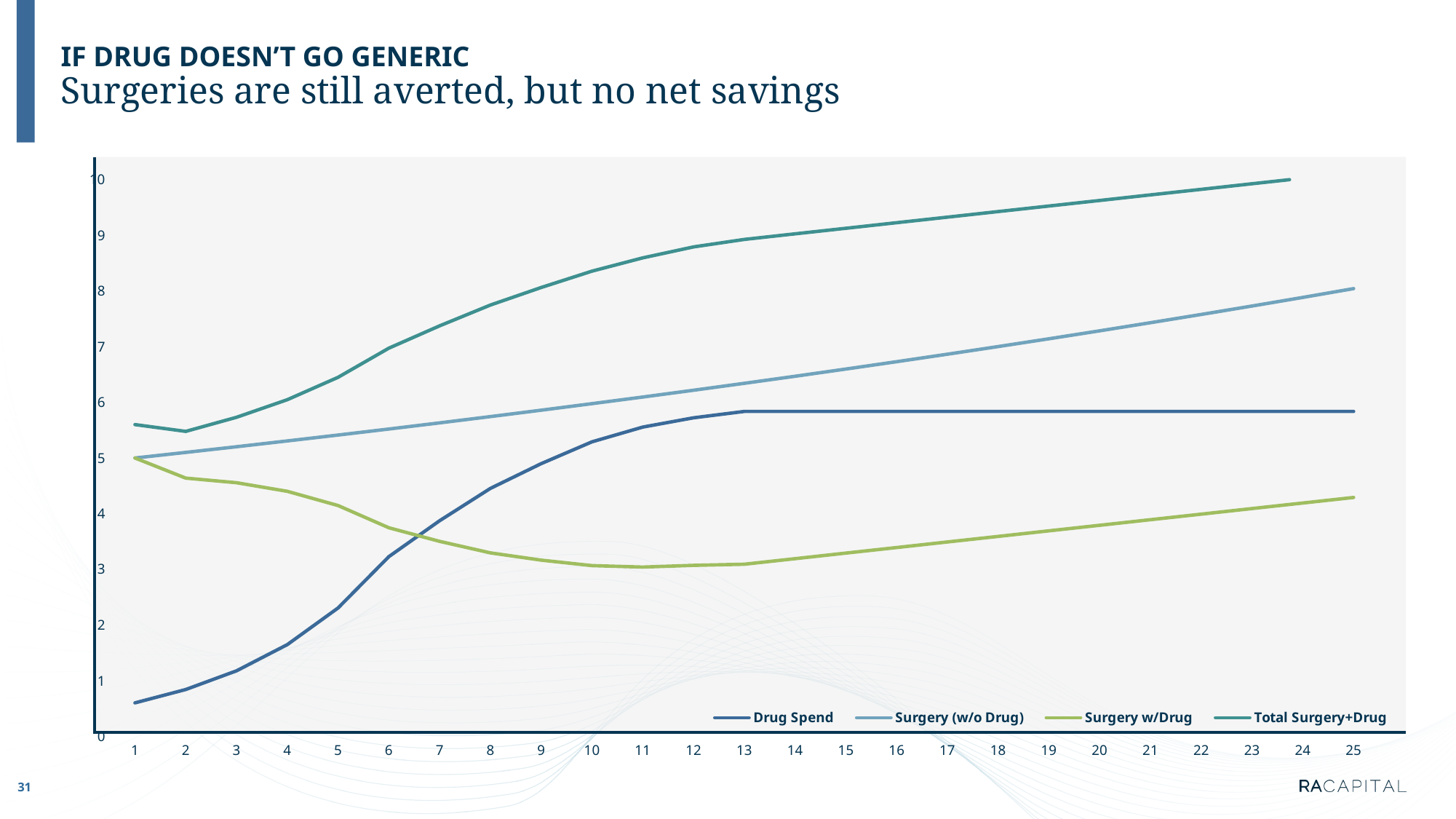
At x = 1, what is the value of the Surgery (w/o Drug) series? 5 Which series has the highest value at x = 25? Total Surgery+Drug At x = 5, which is larger: Drug Spend or Surgery w/Drug? Surgery w/Drug Is the value of Drug Spend at x = 1 greater or less than 1? less Is the value of Total Surgery+Drug at x = 13 greater or less than 8? greater What kind of chart is shown on the slide? line chart Is the value of Surgery w/Drug at x = 25 greater or less than 4? greater Which series has the lowest value at x = 25? Surgery w/Drug Which legend entry is drawn in light green? Surgery w/Drug How many series does the legend list? 4 Does the Surgery (w/o Drug) series rise or fall along the x axis? rise How many points are marked along the x axis? 25